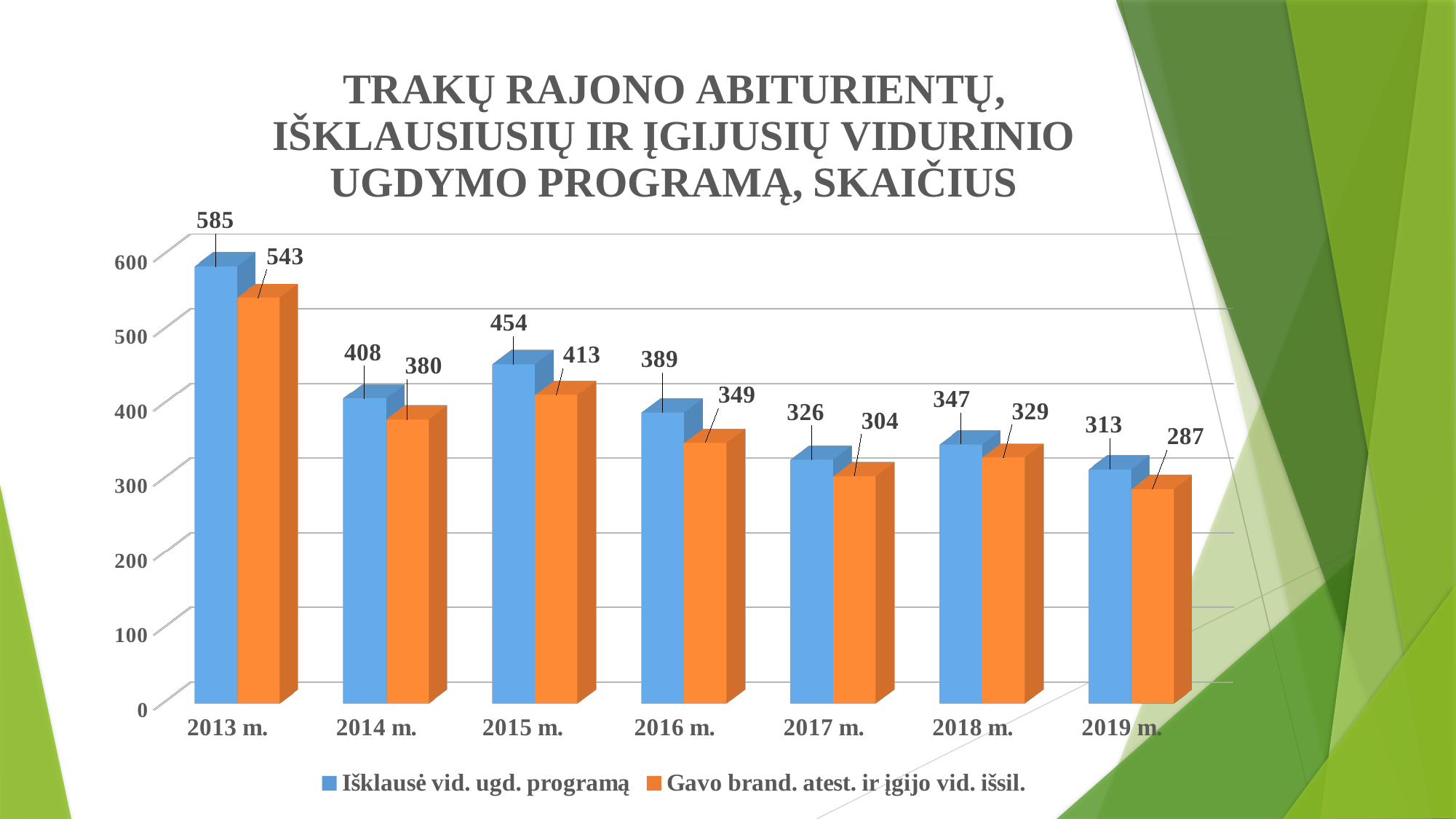
Is the value for 'Gavo brand. atest. ir įgijo vid. išsil.' in 2014 m. greater or less than 400? less How many series does the legend list? 2 What is the difference between 'Išklausė vid. ugd. programą' and 'Gavo brand. atest. ir įgijo vid. išsil.' in 2015 m.? 41 How many years are shown on the x axis? 7 What kind of chart is shown on the slide? bar chart Which is larger: 'Išklausė vid. ugd. programą' in 2017 m. or in 2018 m.? 2018 m. Which year has the highest value for 'Gavo brand. atest. ir įgijo vid. išsil.'? 2013 m. Does the value for 'Išklausė vid. ugd. programą' rise or fall from 2013 m. to 2014 m.? fall Which year has the lowest value for 'Išklausė vid. ugd. programą'? 2019 m. What is the value for 'Išklausė vid. ugd. programą' in 2013 m.? 585 What is the value for 'Gavo brand. atest. ir įgijo vid. išsil.' in 2016 m.? 349 What is the value for 'Išklausė vid. ugd. programą' in 2019 m.? 313